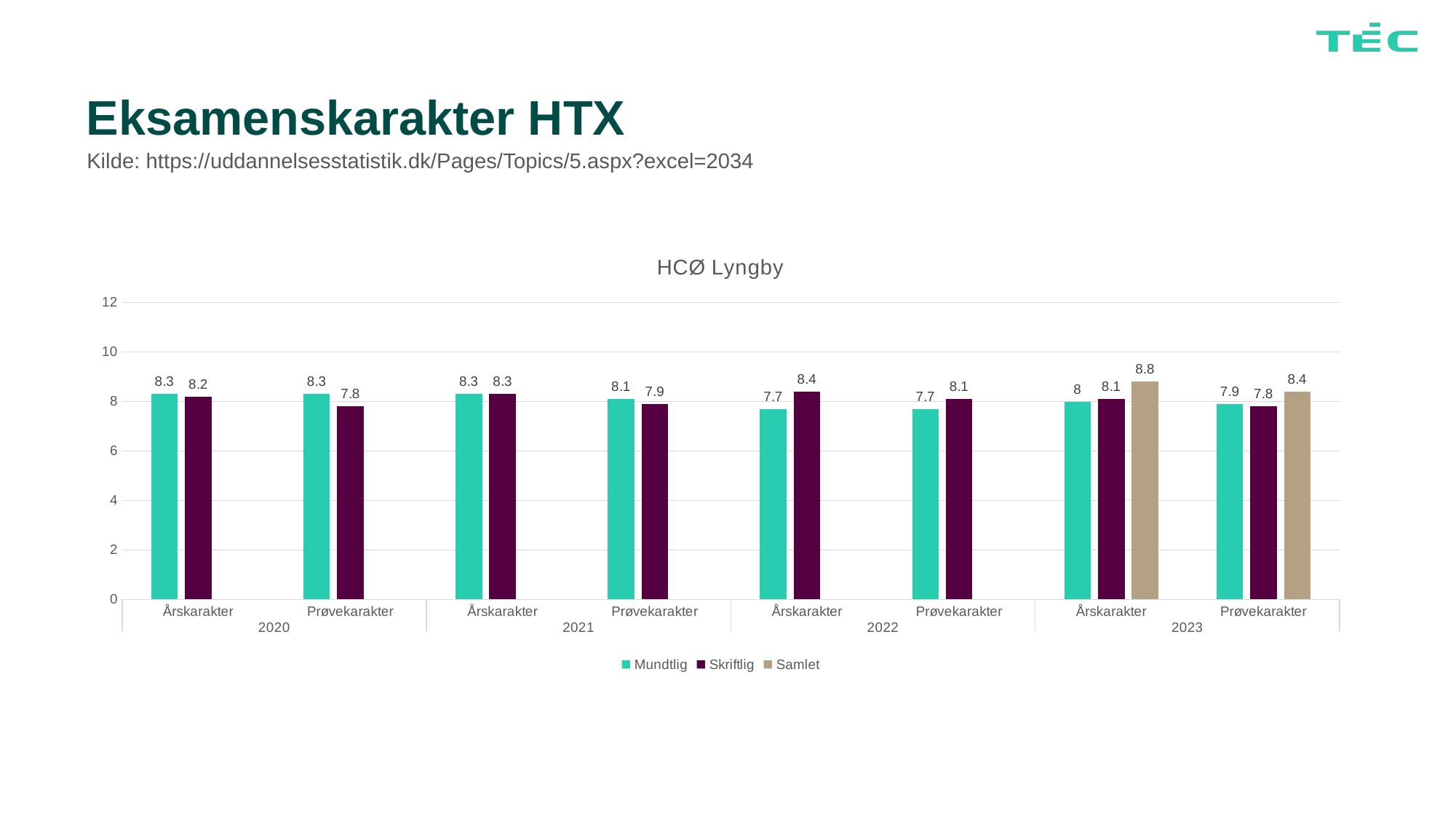
What is the Skriftlig value for Årskarakter in 2022? 8.4 Which is larger for Prøvekarakter in 2021: Mundtlig or Skriftlig? Mundtlig What is the difference between the Skriftlig and Mundtlig values for Årskarakter in 2022? 0.7 How many series does the legend list? 3 In which year does the Samlet series first appear in the chart? 2023 Is the Mundtlig value for Prøvekarakter in 2022 greater or less than 8? less What is the Skriftlig value for Prøvekarakter in 2020? 7.8 What is the title of the chart? HCØ Lyngby Which bar in the chart has the highest value? Samlet, Årskarakter 2023 What is the Mundtlig value for Årskarakter in 2020? 8.3 What is the Samlet value for Årskarakter in 2023? 8.8 What kind of chart is shown on the slide? Bar chart